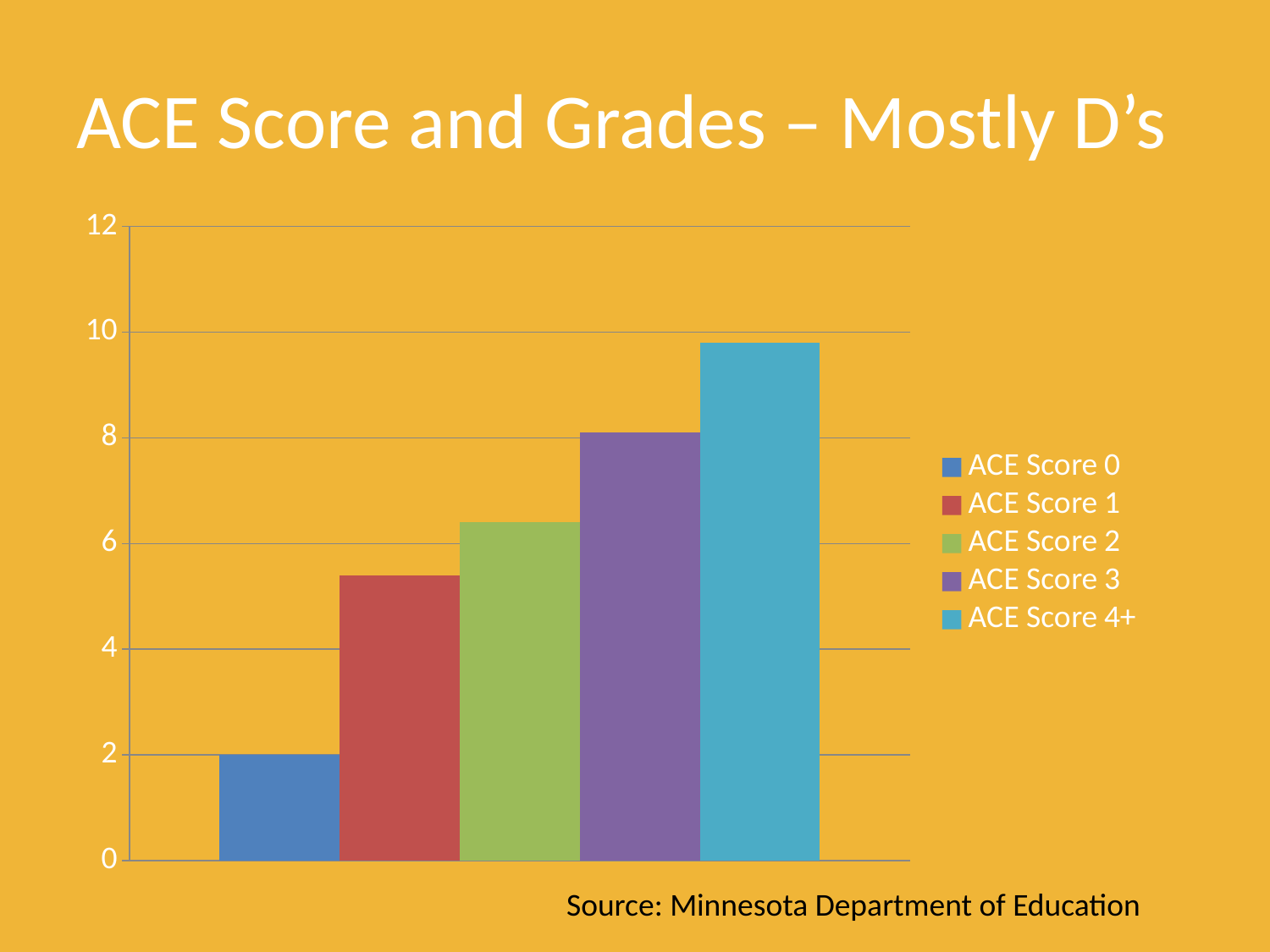
Do the bar values rise or fall from ACE Score 0 to ACE Score 4+? rise What is the title of the chart on the slide? ACE Score and Grades – Mostly D's What is the value for ACE Score 0? 2 What kind of chart is shown on the slide? bar chart Is the value for ACE Score 1 greater or less than 6? less Which is larger, the value for ACE Score 3 or the value for ACE Score 1? ACE Score 3 How many series does the legend list? 5 Is the value for ACE Score 1 greater or less than 4? greater Which series has the lowest bar? ACE Score 0 Is the value for ACE Score 3 greater or less than 6? greater Which series has the highest bar? ACE Score 4+